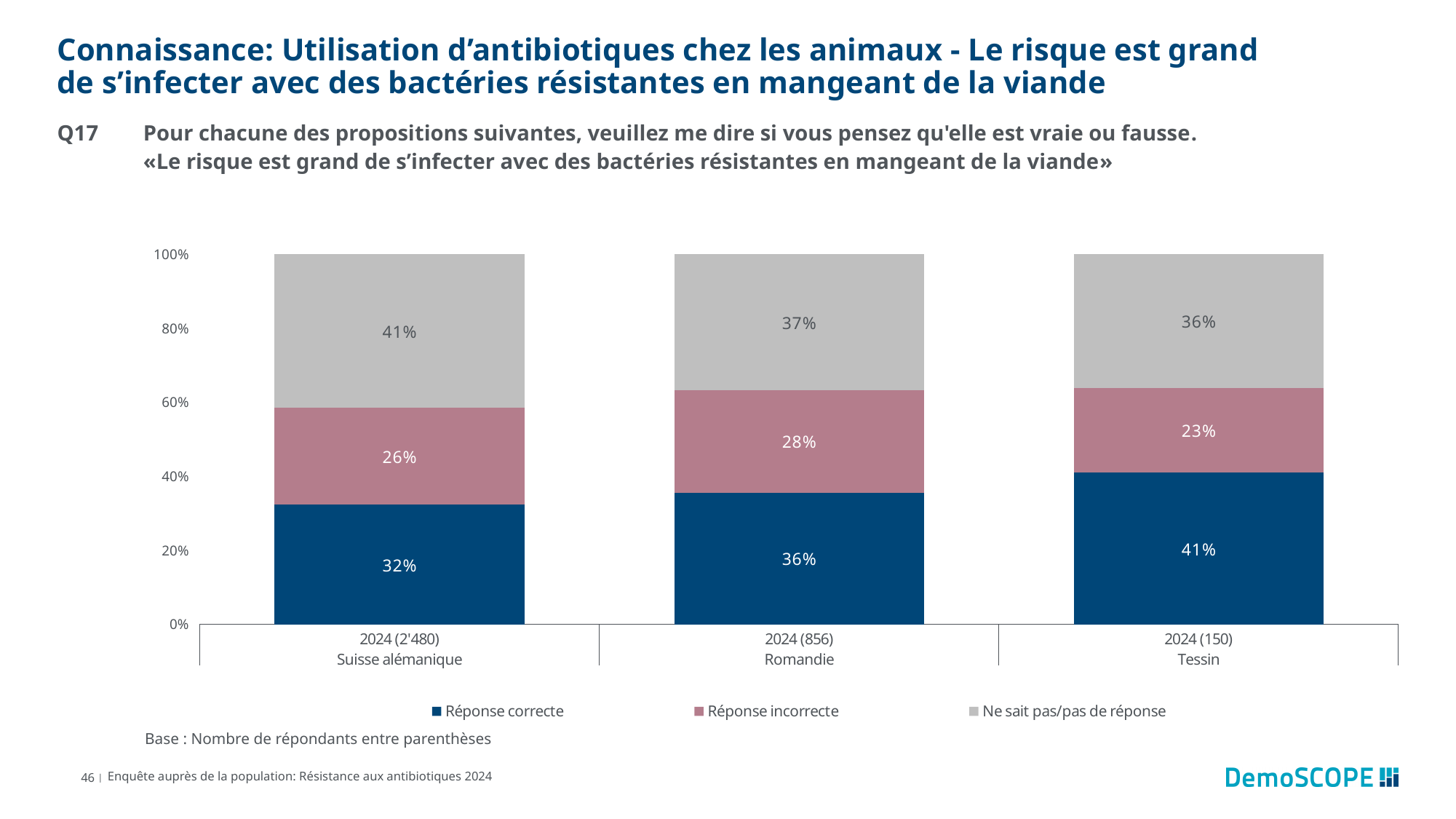
How many series does the legend list? 3 What is the value for 'Réponse incorrecte' in Romandie? 28% What is the difference between the 'Réponse correcte' values for Tessin and Suisse alémanique? 9 percentage points Which is larger: 'Réponse incorrecte' in Suisse alémanique or in Romandie? Romandie How many regions are shown on the x axis? 3 Does the 'Réponse correcte' value rise or fall from Suisse alémanique to Tessin? Rise What is the value for 'Réponse correcte' in Suisse alémanique? 32% Which region has the highest value for 'Réponse correcte'? Tessin Which region has the lowest value for 'Ne sait pas/pas de réponse'? Tessin What is the number of respondents shown in parentheses for Romandie? 856 What is the value for 'Ne sait pas/pas de réponse' in Tessin? 36% What kind of chart is shown on the slide? Stacked bar chart